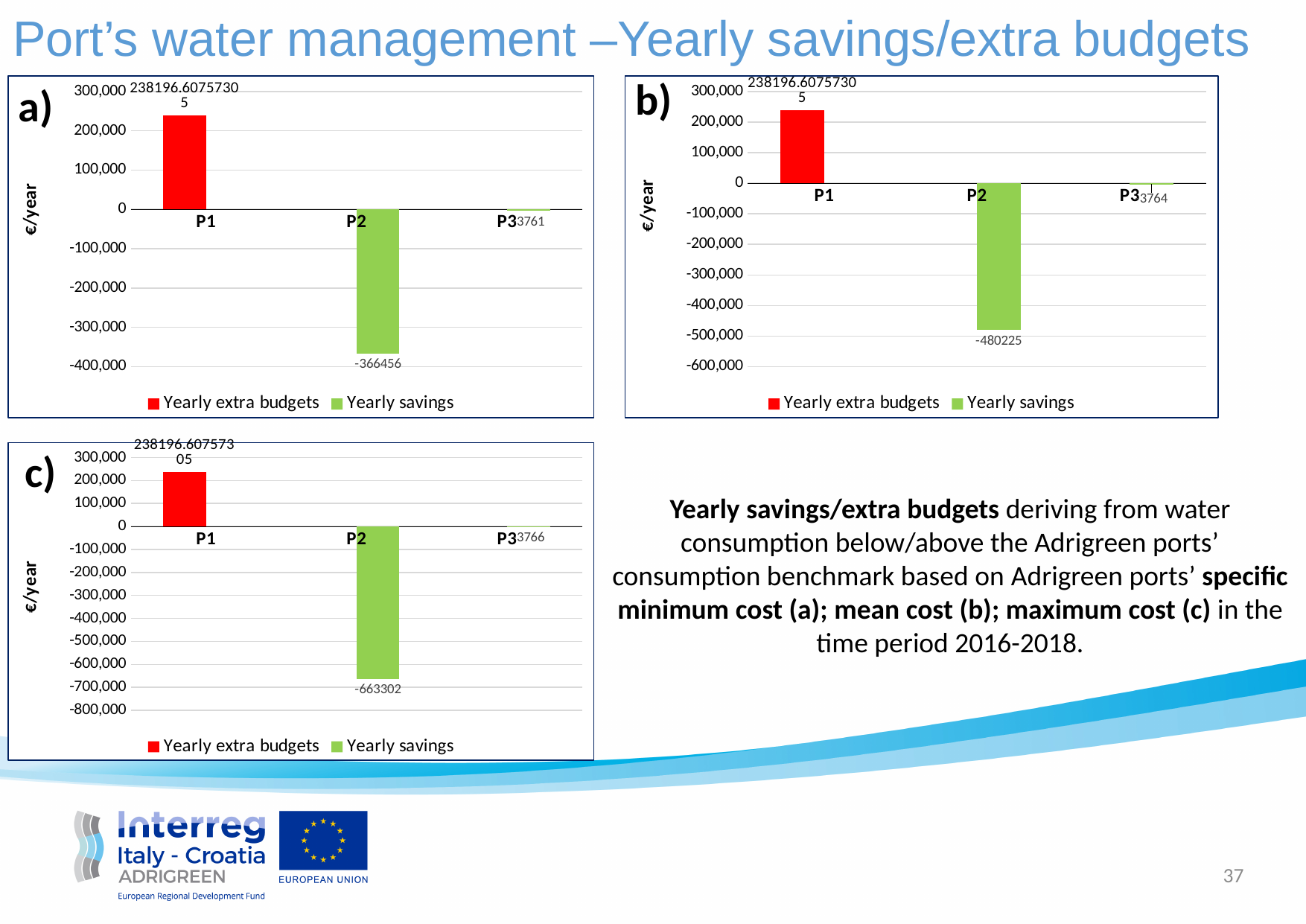
In chart a), what is the value for P2? -366456 In chart c), which category has the highest value? P1 In chart c), what is the value for P3? -3766 In chart a), what is the value for P3? -3761 In chart a), which category has the lowest value? P2 In chart b), what is the value for P2? -480225 In chart b), what is the value for P3? -3764 In chart a), what is the difference between the value for P3 and the value for P2? 362695 How many series does the legend of chart c) list? 2 How many categories are shown on the x axis of chart b)? 3 In chart c), what is the value for P2? -663302 In chart b), which is larger, the value for P1 or the value for P3? P1